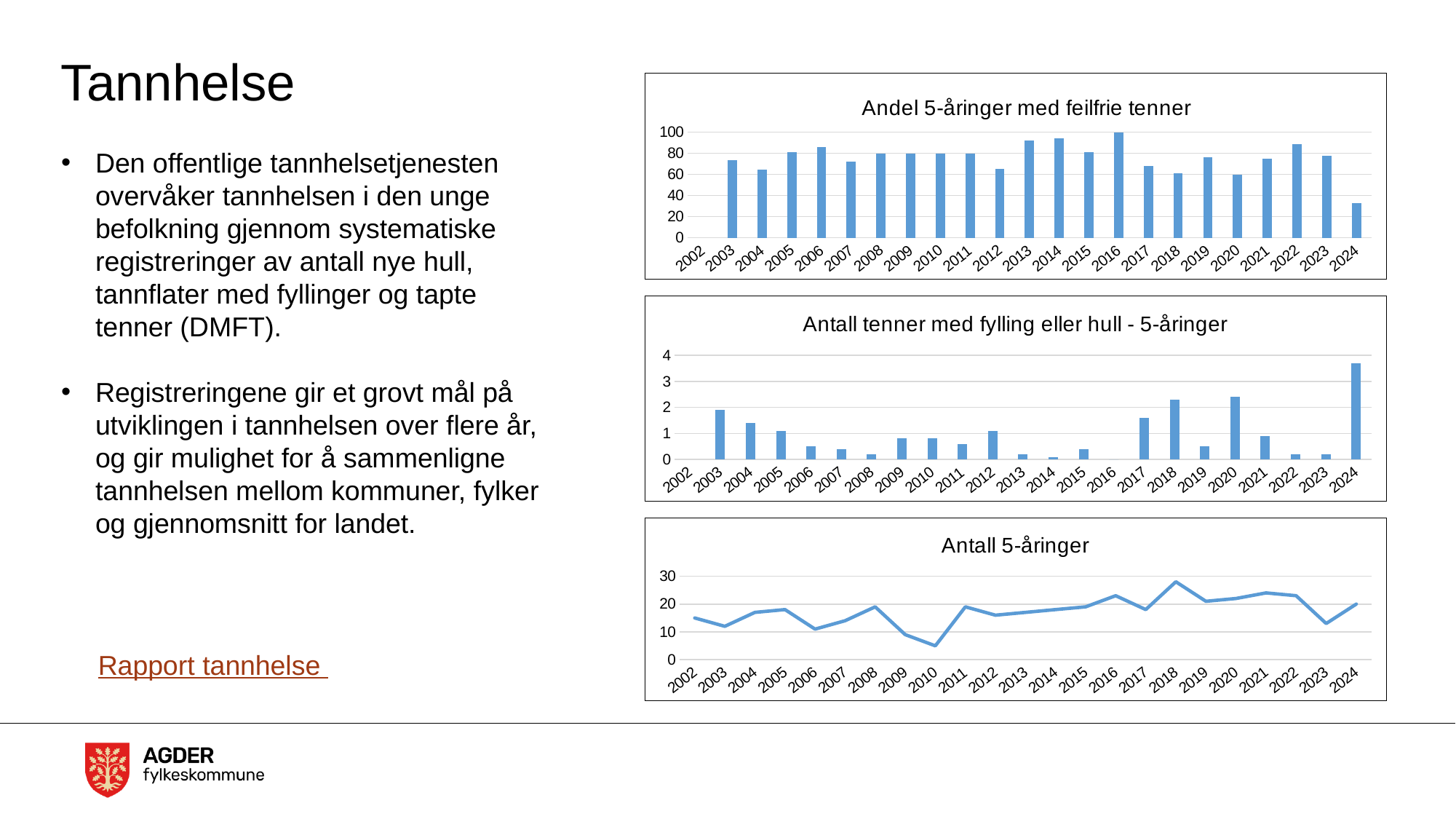
In the middle chart 'Antall tenner med fylling eller hull - 5-åringer', is the value for 2024 greater or less than 3? greater In the middle chart 'Antall tenner med fylling eller hull - 5-åringer', which year has the highest value? 2024 In the top chart 'Andel 5-åringer med feilfrie tenner', which year has the lowest value among the years with a bar? 2024 In the bottom chart 'Antall 5-åringer', is the value for 2010 greater or less than 10? less In the top chart 'Andel 5-åringer med feilfrie tenner', is the value for 2013 greater or less than 80? greater What kind of chart is the top chart, 'Andel 5-åringer med feilfrie tenner'? bar chart In the middle chart 'Antall tenner med fylling eller hull - 5-åringer', which is larger, the value for 2018 or the value for 2019? 2018 How many years are shown on the x axis of the bottom chart 'Antall 5-åringer'? 23 In the bottom chart 'Antall 5-åringer', which year has the highest value? 2018 What kind of chart is the bottom chart, 'Antall 5-åringer'? line chart In the top chart 'Andel 5-åringer med feilfrie tenner', which year has the highest value? 2016